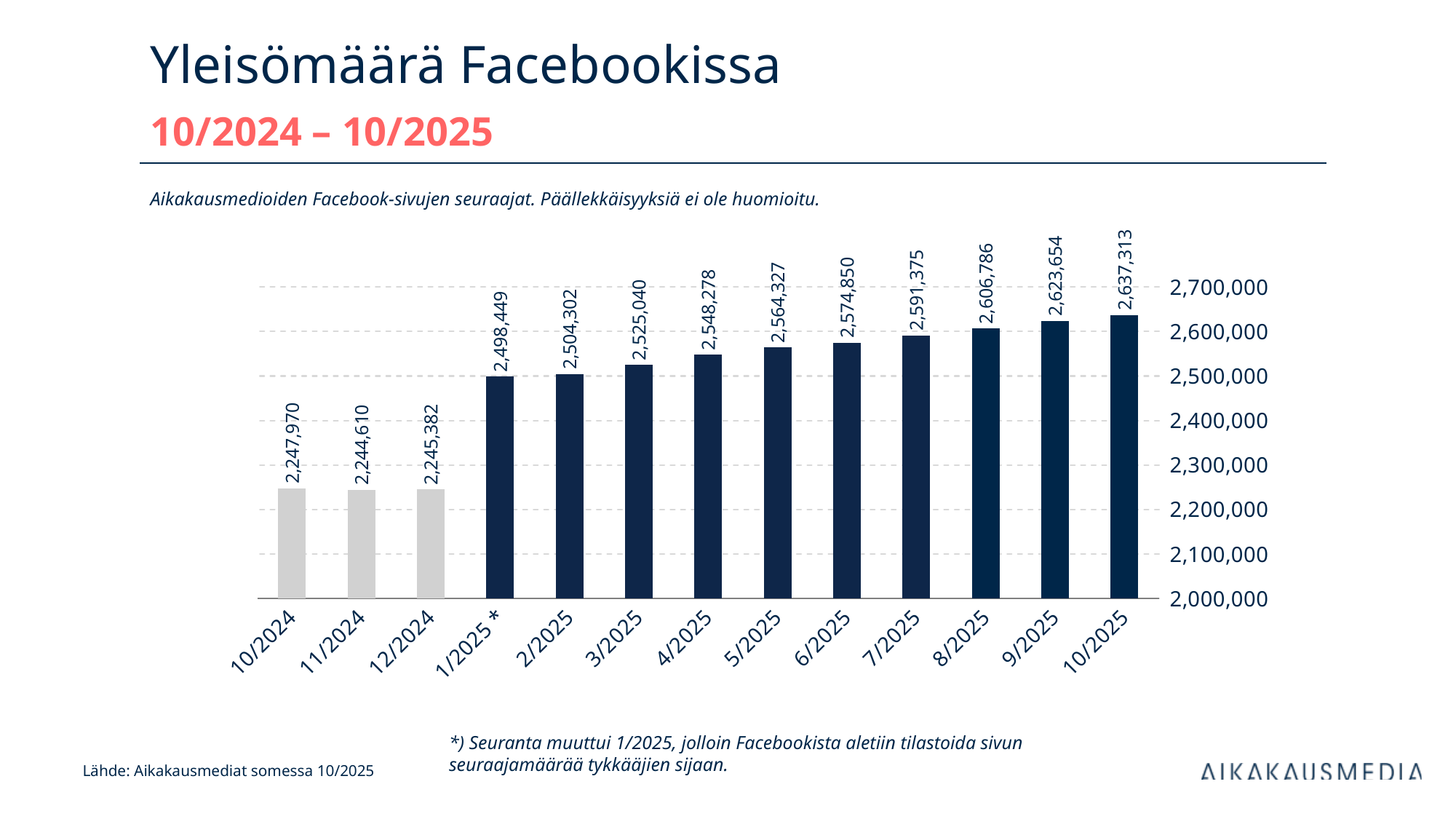
How many months (bars) are plotted in the chart? 13 What is the value for 1/2025 *? 2,498,449 What is the value for 10/2025? 2,637,313 Do the values generally rise or fall from 1/2025 to 10/2025? rise Which is larger, the value for 3/2025 or the value for 12/2024? 3/2025 What is the difference between the values for 10/2025 and 10/2024? 389,343 Which month has the highest value? 10/2025 What is the value for 6/2025? 2,574,850 Which month has the lowest value? 11/2024 What type of chart is shown on the slide? bar chart What is the value for 10/2024? 2,247,970 What is the difference between the values for 1/2025 * and 12/2024? 253,067